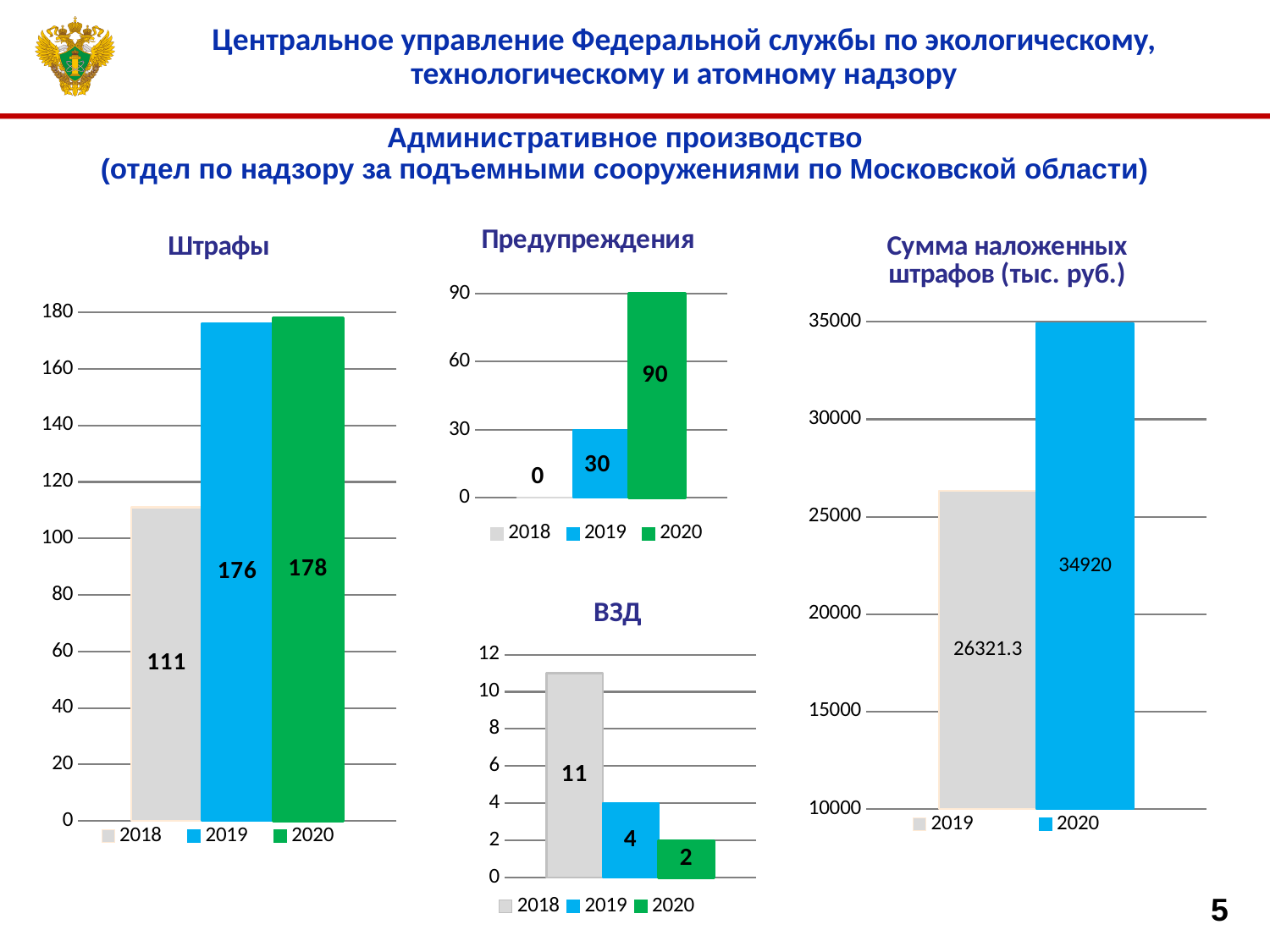
In the 'ВЗД' chart, which is larger, the value for 2018 or the value for 2020? 2018 In the 'Предупреждения' chart, which year has the lowest value? 2018 In the 'Штрафы' chart, what is the value for 2018? 111 In the 'Предупреждения' chart, what is the value for 2020? 90 In the 'Сумма наложенных штрафов (тыс. руб.)' chart, is the value for 2020 greater or less than 30000? greater In the 'Сумма наложенных штрафов (тыс. руб.)' chart, what is the value for 2019? 26321.3 In the 'Штрафы' chart, what is the difference between the 2019 and 2018 values? 65 What kind of chart is the 'Сумма наложенных штрафов (тыс. руб.)' chart? bar chart In the 'ВЗД' chart, what is the value for 2019? 4 In the 'ВЗД' chart, how many series does the legend list? 3 In the 'Штрафы' chart, which year has the highest value? 2020 In the 'Предупреждения' chart, do the values rise or fall from 2018 to 2020? rise